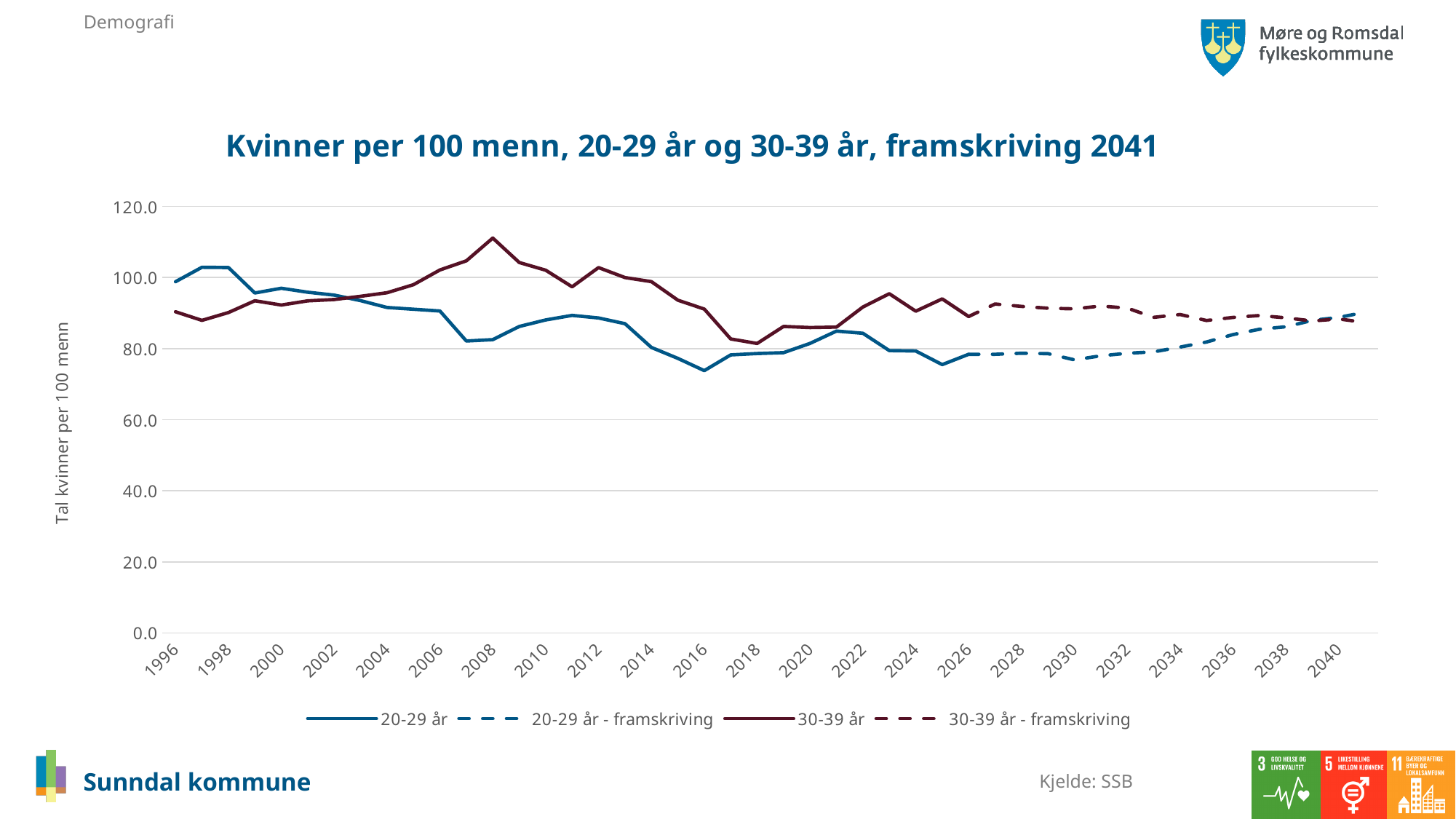
In 2008, which series has the higher value, 20-29 år or 30-39 år? 30-39 år What kind of chart is shown on the slide? line chart Is the value for 30-39 år - framskriving in 2028 greater or less than 80? greater Is the value for 20-29 år in 2016 greater or less than 80? less Is the value for 30-39 år in 2008 greater or less than 100? greater How many series does the legend list? 4 What is the title of the chart? Kvinner per 100 menn, 20-29 år og 30-39 år, framskriving 2041 Which series reaches the highest value anywhere on the chart? 30-39 år In 1998, which series has the higher value, 20-29 år or 30-39 år? 20-29 år What is the label on the vertical axis? Tal kvinner per 100 menn Does the 20-29 år - framskriving line rise or fall between 2030 and 2040? rise